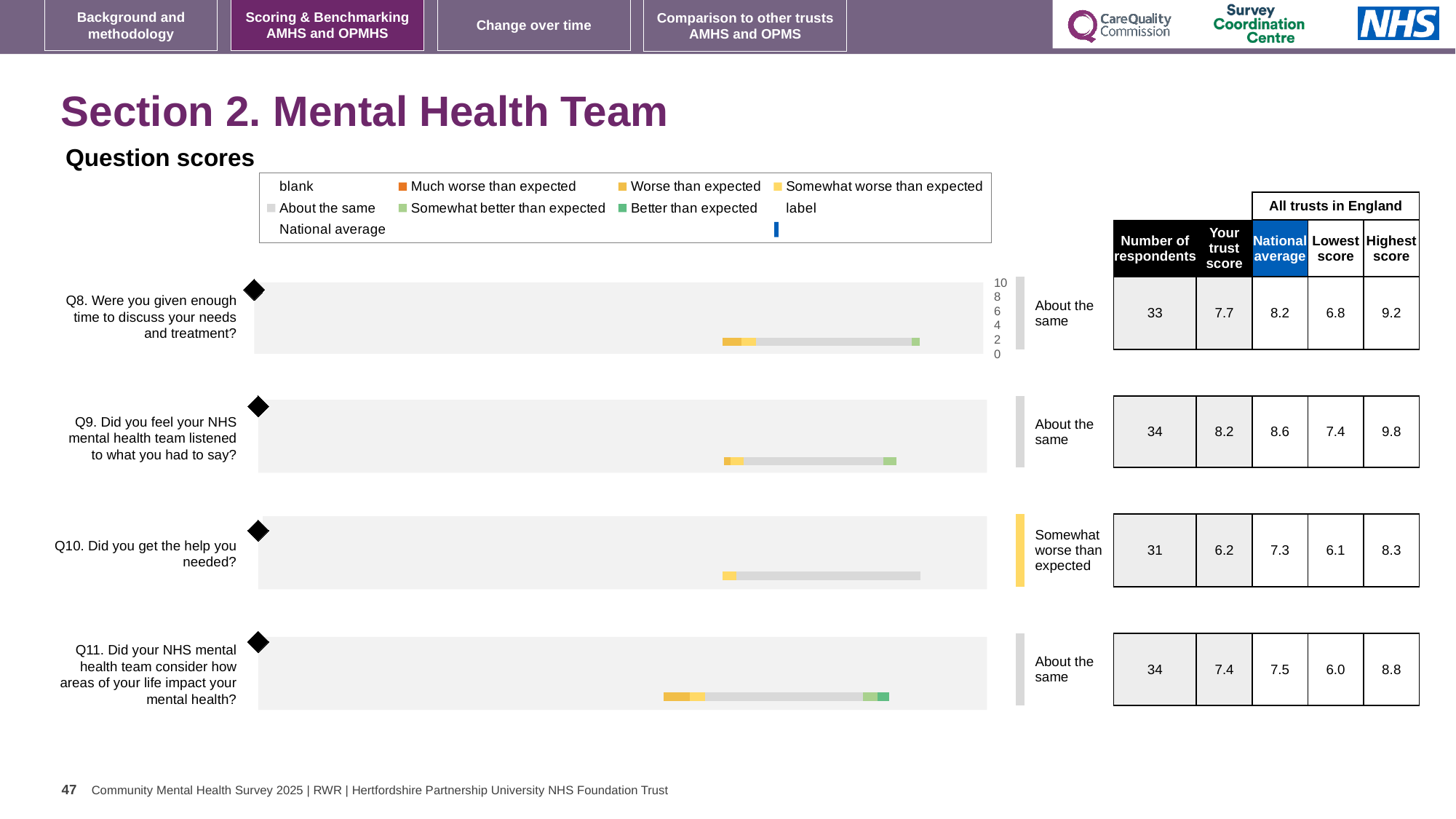
What benchmark category is shown for Q10? Somewhat worse than expected Which question has the highest national average score? Q9 What type of chart is used to show the question scores? Bar chart What is the difference between the highest score and the lowest score for Q10? 2.2 How many respondents answered Q9 (Did you feel your NHS mental health team listened to what you had to say)? 34 What is the 'Your trust score' for Q8 (Were you given enough time to discuss your needs and treatment)? 7.7 What is the national average score for Q10 (Did you get the help you needed)? 7.3 For Q8, which is larger: the trust score or the national average? National average What is the difference between the national average and the trust score for Q9? 0.4 How many questions are plotted on the slide? 4 Which question has the lowest 'Your trust score'? Q10 What is the highest score among all trusts in England for Q11? 8.8